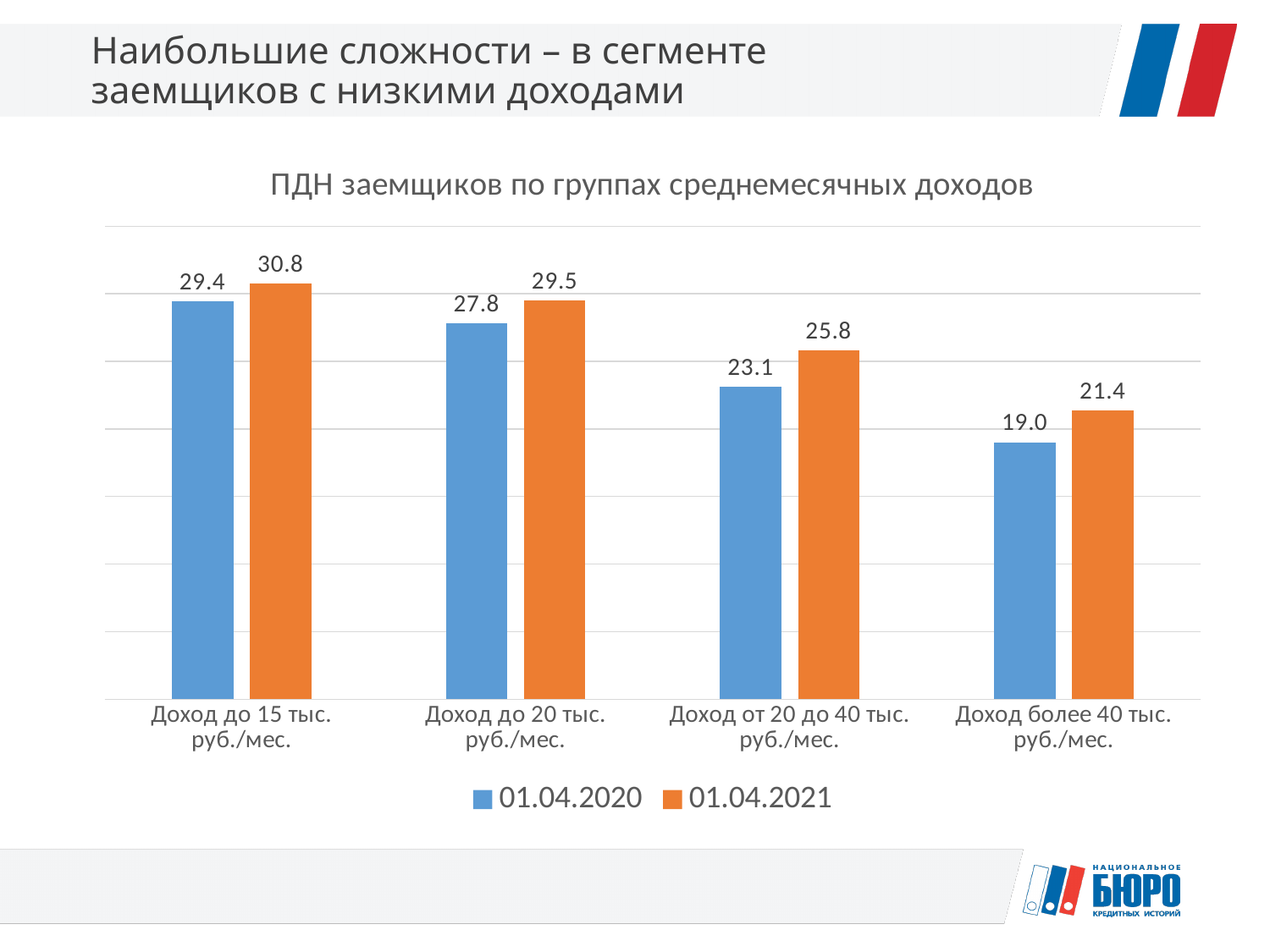
How many series does the legend list? 2 Which income group has the highest value in the 01.04.2020 series? Доход до 15 тыс. руб./мес. What kind of chart is shown on the slide? Bar chart Do the 01.04.2021 values rise or fall moving from left to right across the income groups? Fall What is the difference between the 01.04.2021 and 01.04.2020 values for 'Доход до 20 тыс. руб./мес.'? 1.7 How many income groups are shown on the x axis? 4 Which income group has the lowest value in the 01.04.2021 series? Доход более 40 тыс. руб./мес. Which is larger: the 01.04.2020 value for 'Доход до 20 тыс. руб./мес.' or the 01.04.2021 value for 'Доход от 20 до 40 тыс. руб./мес.'? 01.04.2020 value for 'Доход до 20 тыс. руб./мес.' What is the value for 'Доход до 15 тыс. руб./мес.' in the 01.04.2021 series? 30.8 What is the value for 'Доход от 20 до 40 тыс. руб./мес.' in the 01.04.2021 series? 25.8 What is the value for 'Доход более 40 тыс. руб./мес.' in the 01.04.2020 series? 19.0 What is the difference between the 01.04.2021 and 01.04.2020 values for 'Доход от 20 до 40 тыс. руб./мес.'? 2.7